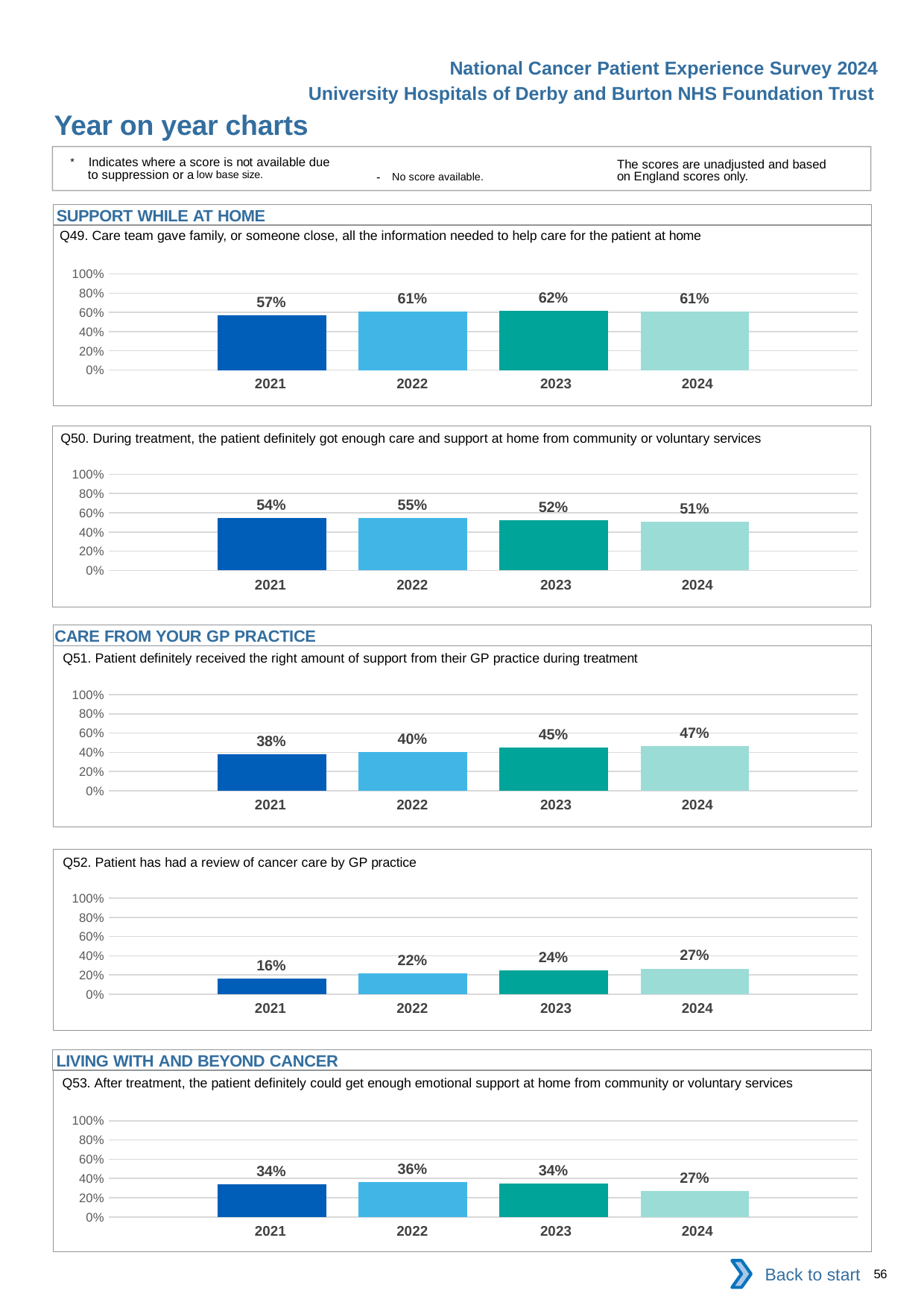
In the Q51 chart, do the values rise or fall from 2021 to 2024? rise In the Q49 chart, which year has the lowest value? 2021 How many years are shown on the x axis of the Q49 chart? 4 What kind of chart is used for Q52? bar chart In the Q52 chart, is the value for 2024 greater or less than 40%? less In the Q50 chart (enough care and support at home from community or voluntary services), what is the value for 2024? 51% In the Q51 chart (right amount of support from GP practice during treatment), what is the difference between the 2024 and 2021 values? 9 percentage points In the Q53 chart, which is larger, the value for 2022 or the value for 2024? 2022 In the Q50 chart, which year has the highest value? 2022 In the Q53 chart (emotional support at home after treatment), which year has the lowest value? 2024 In the Q52 chart (review of cancer care by GP practice), what is the value for 2021? 16% In the Q49 chart (care team gave family all the information needed to help care for the patient at home), what is the value for 2023? 62%